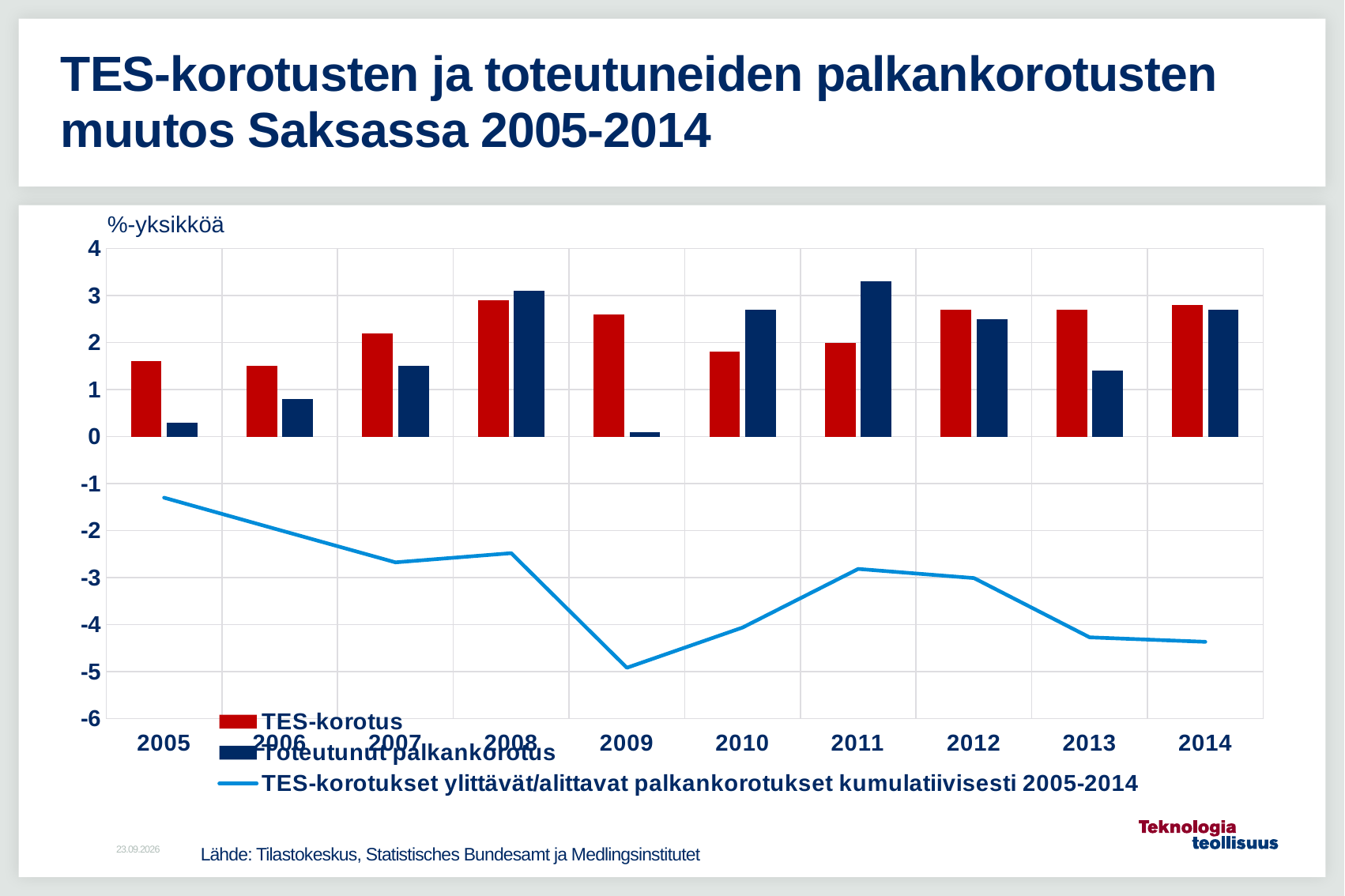
Does the cumulative line rise or fall from 2011 to 2014? Falls Is the value for TES-korotus in 2008 greater or less than 2? greater In which year does the line 'TES-korotukset ylittävät/alittavat palkankorotukset kumulatiivisesti 2005-2014' reach its lowest point? 2009 What kind of chart is shown on the slide? A combined bar and line chart Which year has the lowest value for Toteutunut palkankorotus? 2009 Is the value for Toteutunut palkankorotus in 2009 greater or less than 1? less How many series does the legend list? 3 How many years are shown on the x axis? 10 Is the value of the cumulative line in 2009 greater or less than -4? less Which year has the highest value for Toteutunut palkankorotus? 2011 In 2013, which is larger: TES-korotus or Toteutunut palkankorotus? TES-korotus In 2011, which is larger: TES-korotus or Toteutunut palkankorotus? Toteutunut palkankorotus